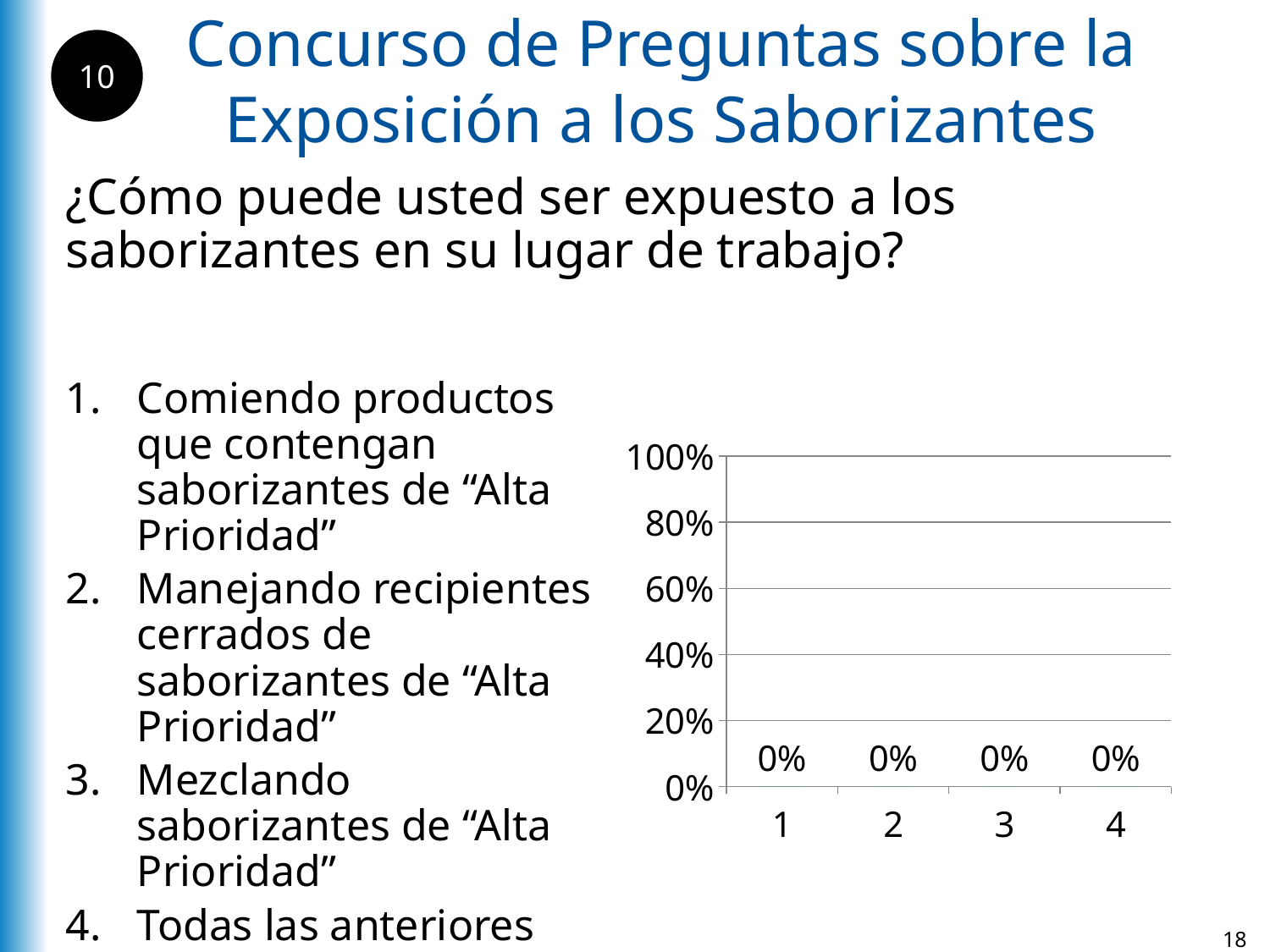
Is the value for category 4 greater or less than 40%? less What is the value shown for category 3? 0% How many categories are shown on the x axis of the chart? 4 What is the difference between the values for category 1 and category 2? 0% Is the value for category 1 greater or less than 20%? less What is the value shown for category 1? 0% What is the highest value labelled on the y axis of the chart? 100% What is the interval between the tick labels on the y axis? 20% What is the value shown for category 2? 0% What kind of chart is shown on the slide? bar chart What is the value shown for category 4? 0%